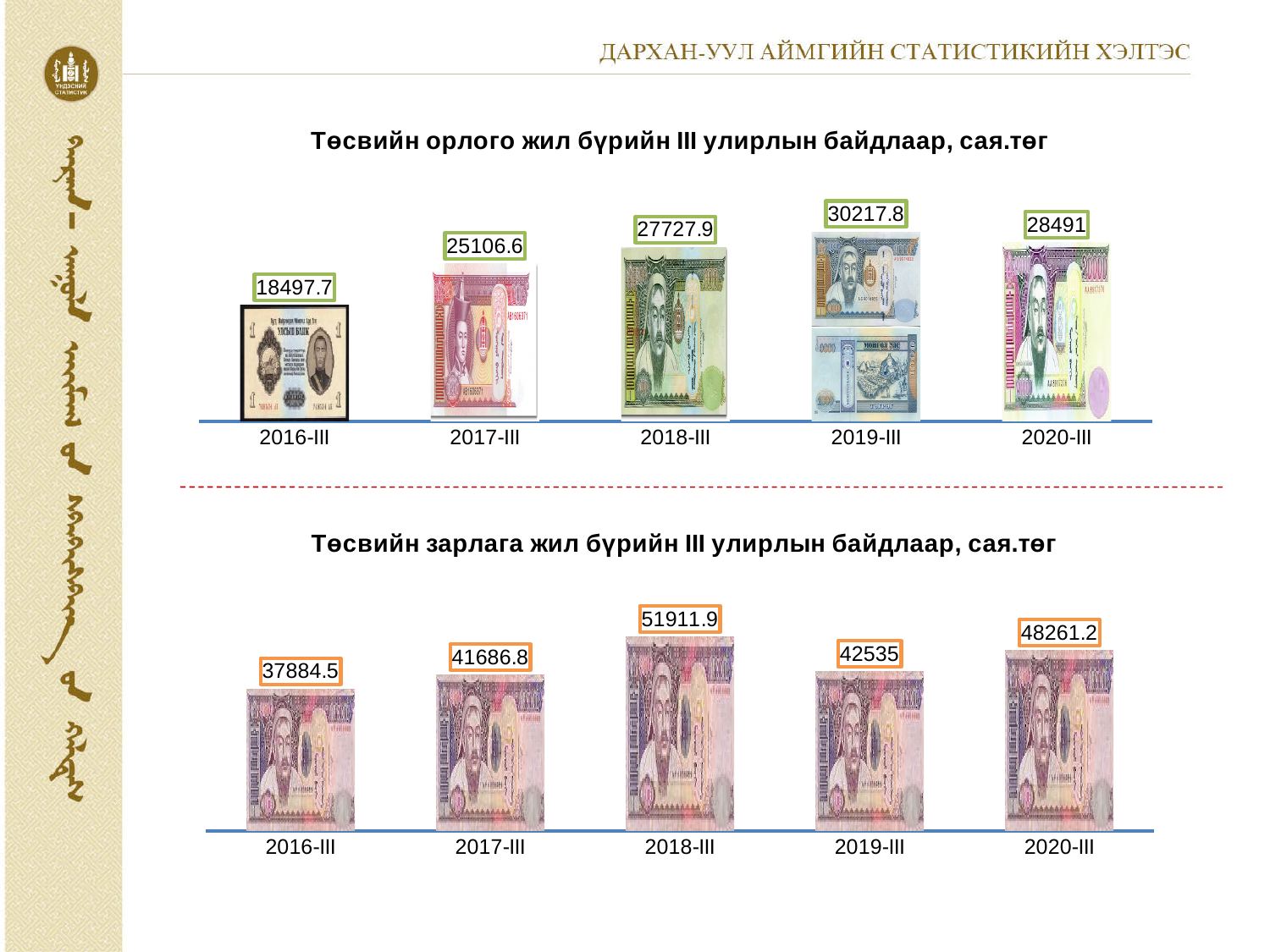
In the top chart (Төсвийн орлого), which period has the highest value? 2019-III In the top chart (Төсвийн орлого), what is the value for 2019-III? 30217.8 What kind of chart is the bottom chart (Төсвийн зарлага)? Bar chart In the top chart (Төсвийн орлого), what is the difference between the values for 2019-III and 2020-III? 1726.8 In the bottom chart (Төсвийн зарлага), what is the difference between the values for 2020-III and 2016-III? 10376.7 In the bottom chart (Төсвийн зарлага), what is the value for 2019-III? 42535 In the bottom chart (Төсвийн зарлага), which is larger, the value for 2017-III or 2020-III? 2020-III In the bottom chart (Төсвийн зарлага), which period has the highest value? 2018-III In the bottom chart (Төсвийн зарлага), what is the value for 2018-III? 51911.9 In the top chart (Төсвийн орлого), what is the value for 2016-III? 18497.7 In the top chart (Төсвийн орлого), which period has the lowest value? 2016-III In the top chart (Төсвийн орлого), how many periods are shown on the x axis? 5